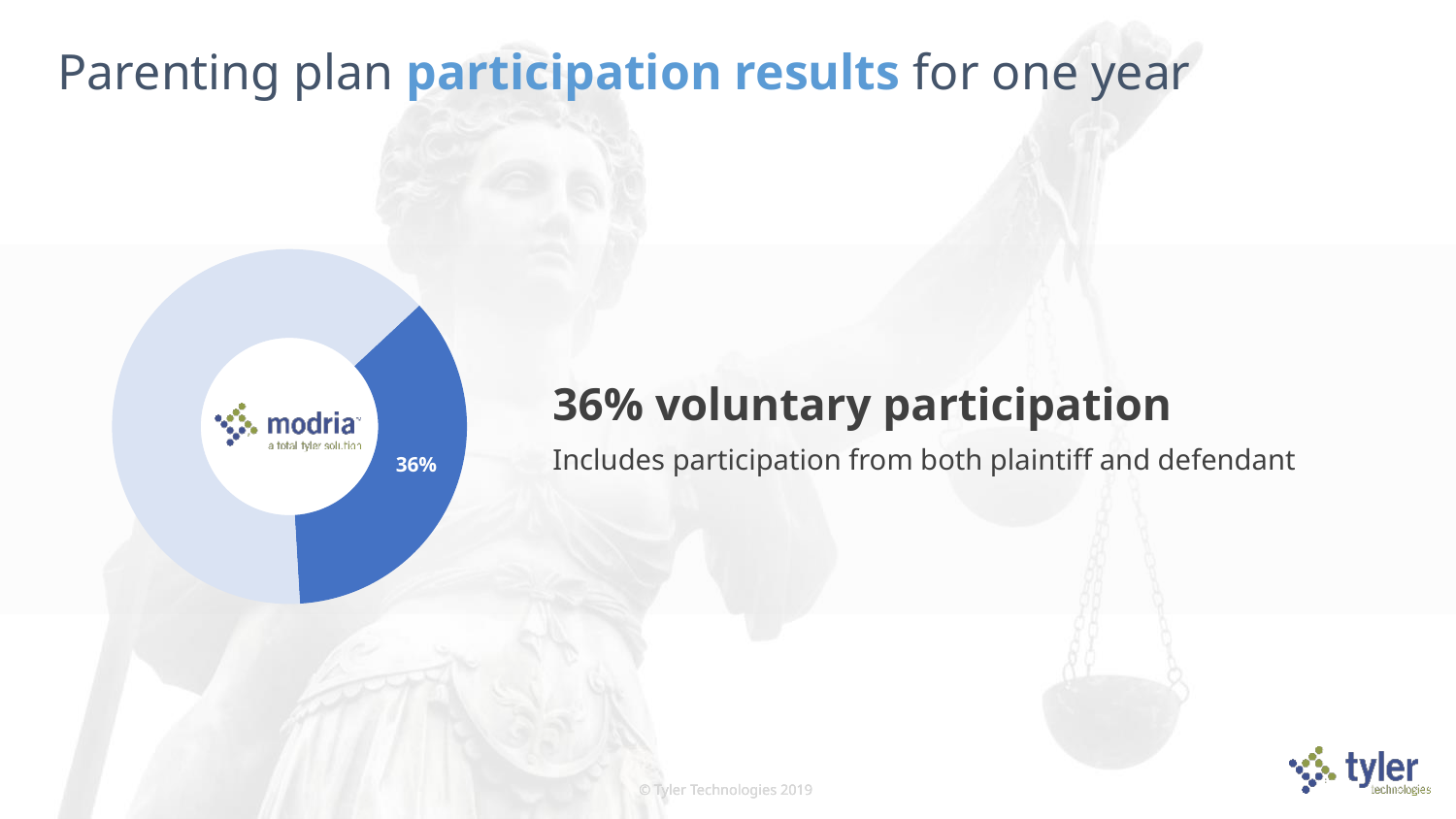
Which slice of the donut chart is larger, the dark blue one or the light blue one? the light blue one What share of the donut chart does the dark blue slice represent? 36% What share of the donut chart does the light blue slice represent? 64% What does the 36% slice of the donut chart represent, according to the slide? voluntary participation What is the title of the slide containing the donut chart? Parenting plan participation results for one year How many slices does the donut chart have? 2 Is the value of the dark blue slice greater or less than 50%? less What percentage is printed on the dark blue slice of the donut chart? 36% What kind of chart is shown on the slide? donut chart